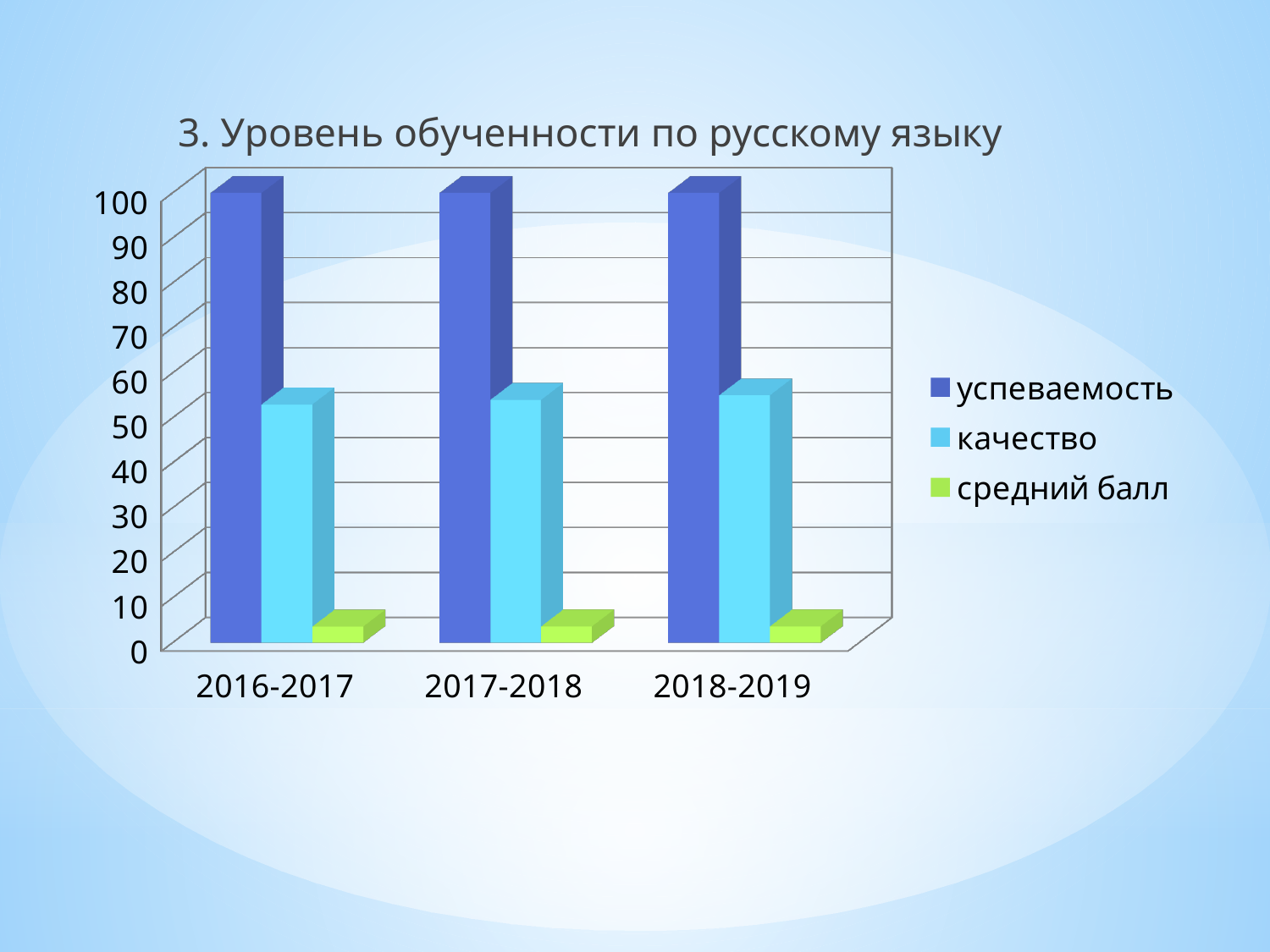
How many categories (school years) are shown on the x axis? 3 What kind of chart is shown on the slide? bar chart Which series has the lowest bar in 2018-2019? средний балл Is the value for качество in 2016-2017 greater or less than 40? greater What is the title of the chart? 3. Уровень обученности по русскому языку Which series is shown in green in the legend? средний балл Is the value for средний балл in 2018-2019 greater or less than 10? less How many series does the legend list? 3 Is the value for успеваемость in 2017-2018 greater or less than 90? greater Which series has the highest bar in 2016-2017? успеваемость In 2018-2019, which is larger: качество or средний балл? качество